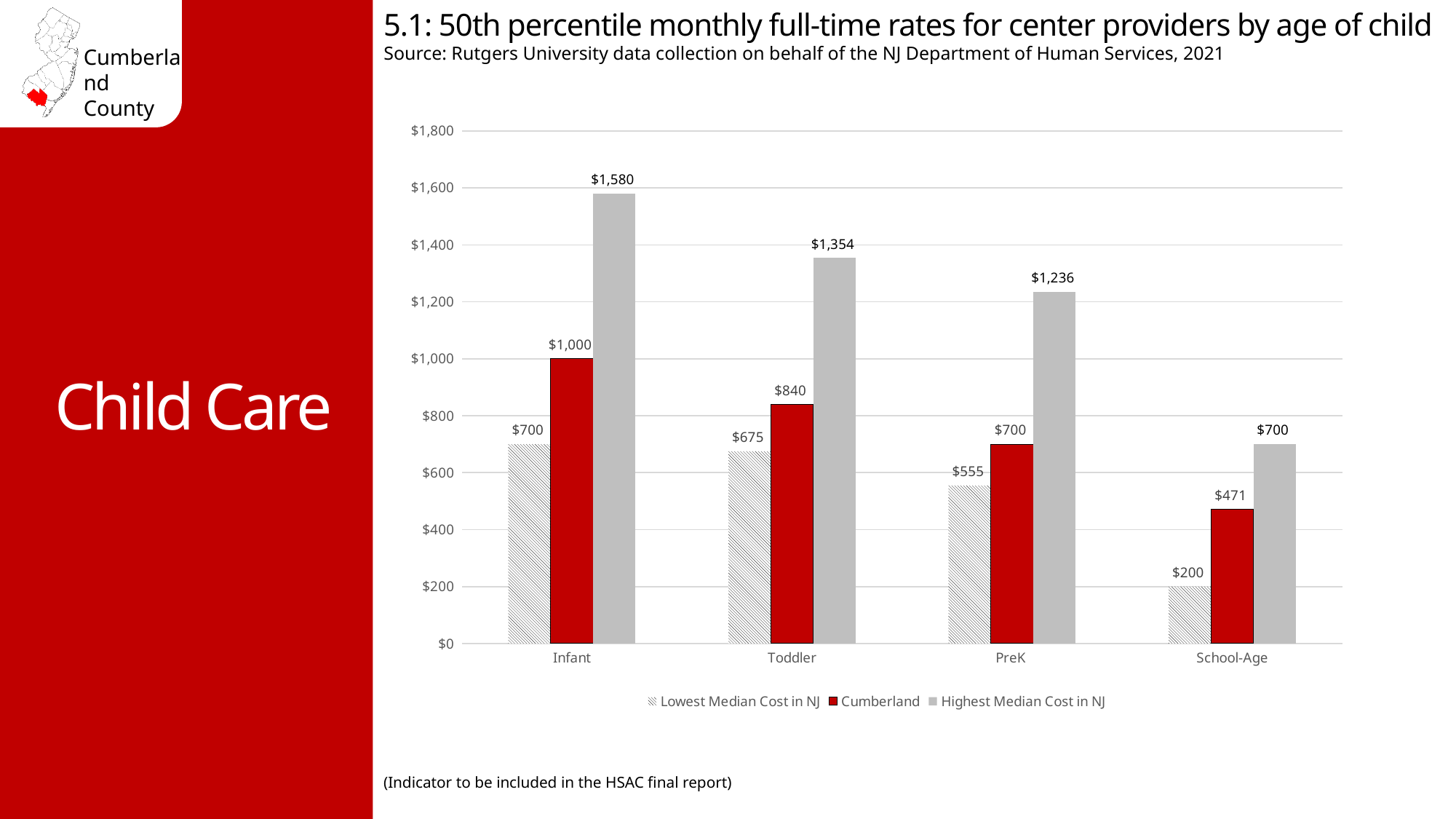
What kind of chart is shown on the slide? Bar chart Do the Cumberland values rise or fall from Infant to School-Age? Fall What is the Cumberland value for Infant? $1,000 Which age category has the highest Cumberland value? Infant Which age category has the lowest Highest Median Cost in NJ? School-Age Which is larger: the Cumberland value for Toddler or the Cumberland value for PreK? Toddler What is the Highest Median Cost in NJ for Toddler? $1,354 Is the Highest Median Cost in NJ for Infant greater or less than $1,400? greater What is the difference between the Highest Median Cost in NJ and the Cumberland value for PreK? $536 How many series does the legend list? 3 What is the Lowest Median Cost in NJ for School-Age? $200 How many age categories are shown on the x axis? 4